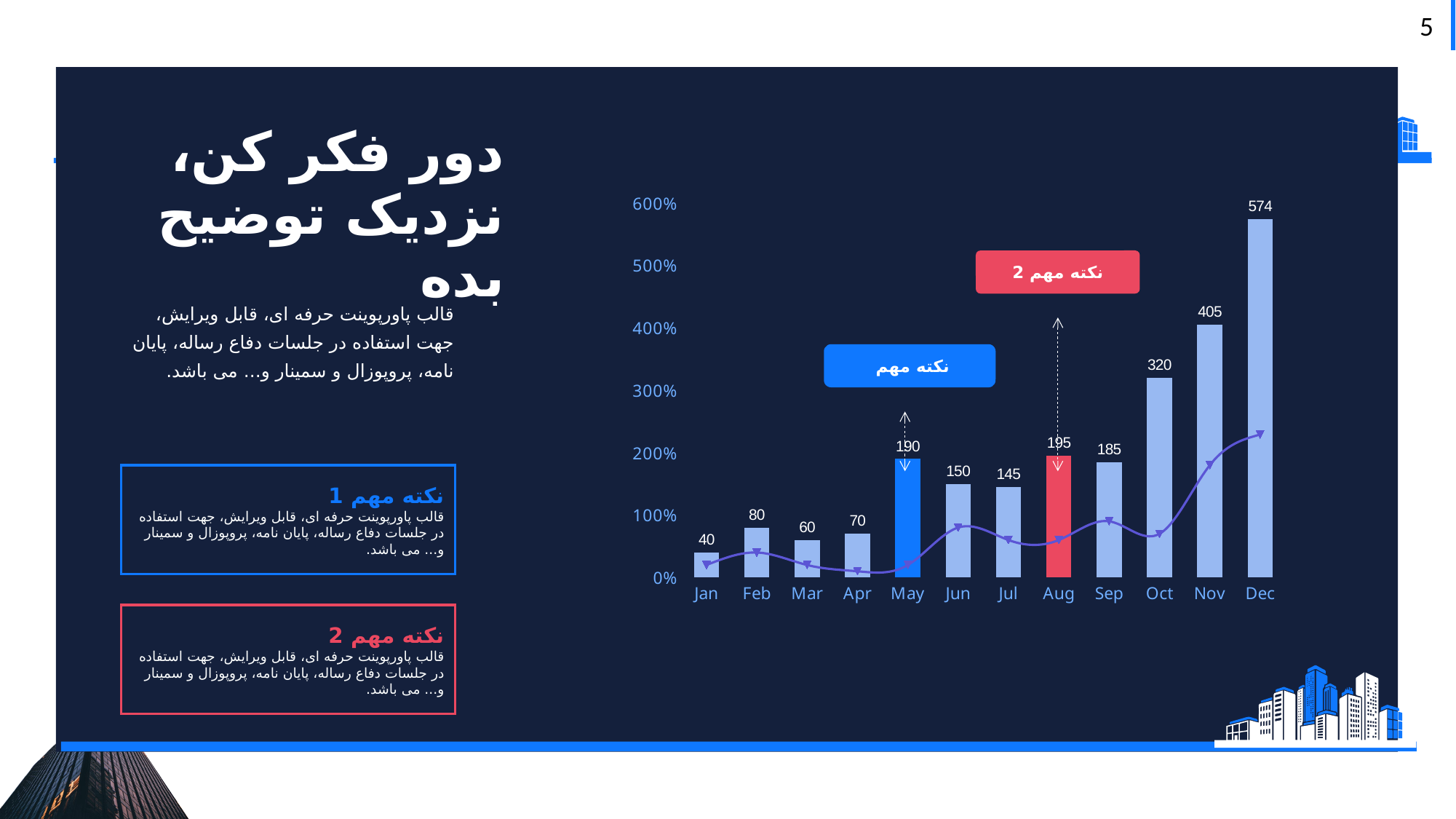
How many months are shown on the x axis? 12 What is the bar value for Dec? 574 Which month's bar is coloured red? Aug What kind of chart is shown? bar chart with a line What is the bar value for May? 190 Which has the larger bar value, Jul or Aug? Aug Do the bar values generally rise or fall from Jan to Dec? rise Which month has the lowest bar? Jan What is the difference between the bar values for Nov and Oct? 85 What is the bar value for Sep? 185 What is the difference between the bar values for Dec and Nov? 169 Which month has the highest bar? Dec